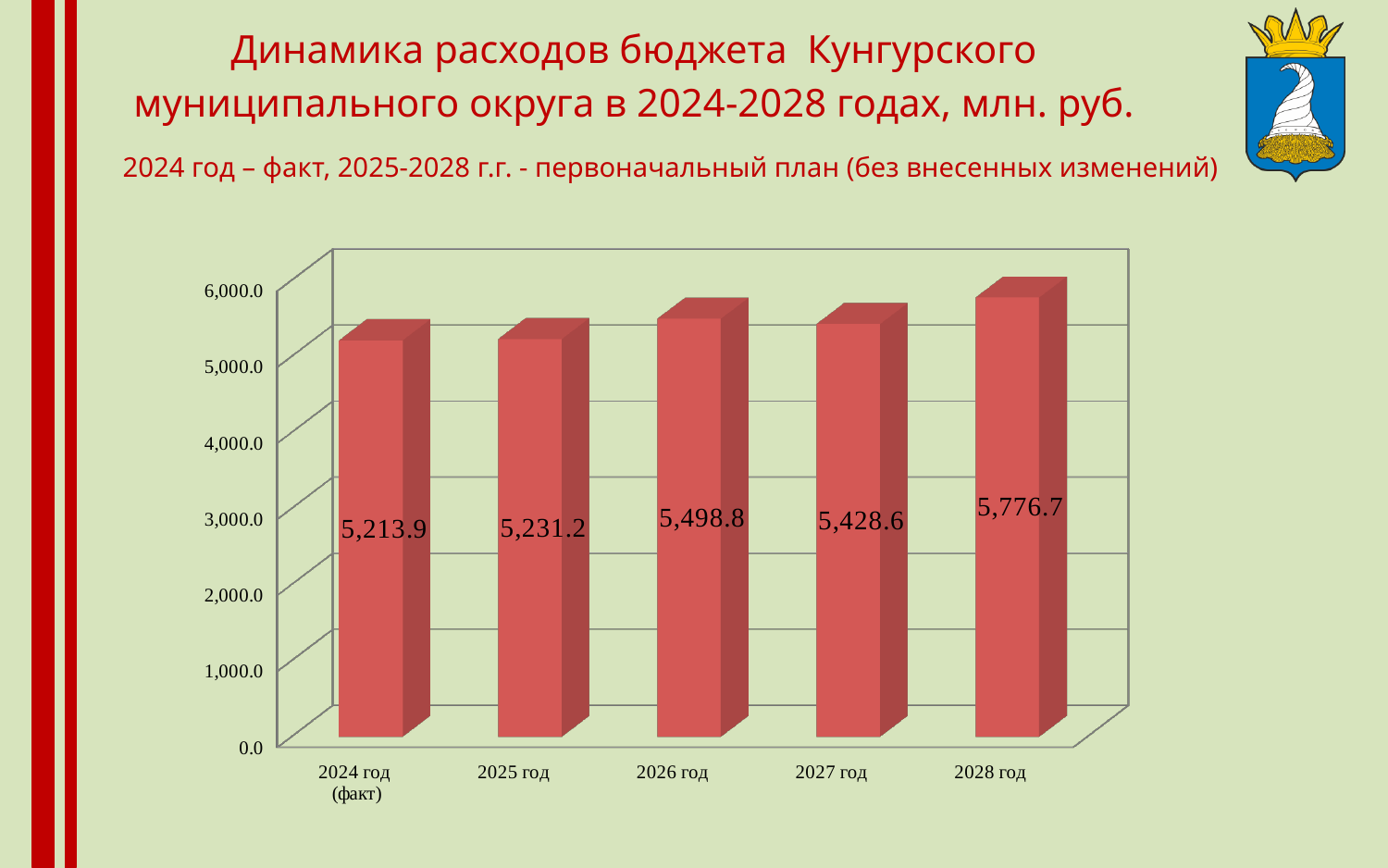
What is the difference between the values for 2026 год and 2027 год? 70.2 Does the value rise or fall from 2026 год to 2027 год? fall What value is shown for 2026 год? 5,498.8 Is the value for 2028 год greater or less than 5,000.0? greater What is the difference between the values for 2028 год and 2024 год (факт)? 562.8 What kind of chart is shown on the slide? bar chart How many years (categories) are shown on the chart? 5 Which year has the lowest value on the chart? 2024 год (факт) What value is shown for 2028 год? 5,776.7 What is the budget expenditure value shown for 2024 год (факт)? 5,213.9 Which year has the highest value on the chart? 2028 год Which is larger, the value for 2026 год or the value for 2027 год? 2026 год